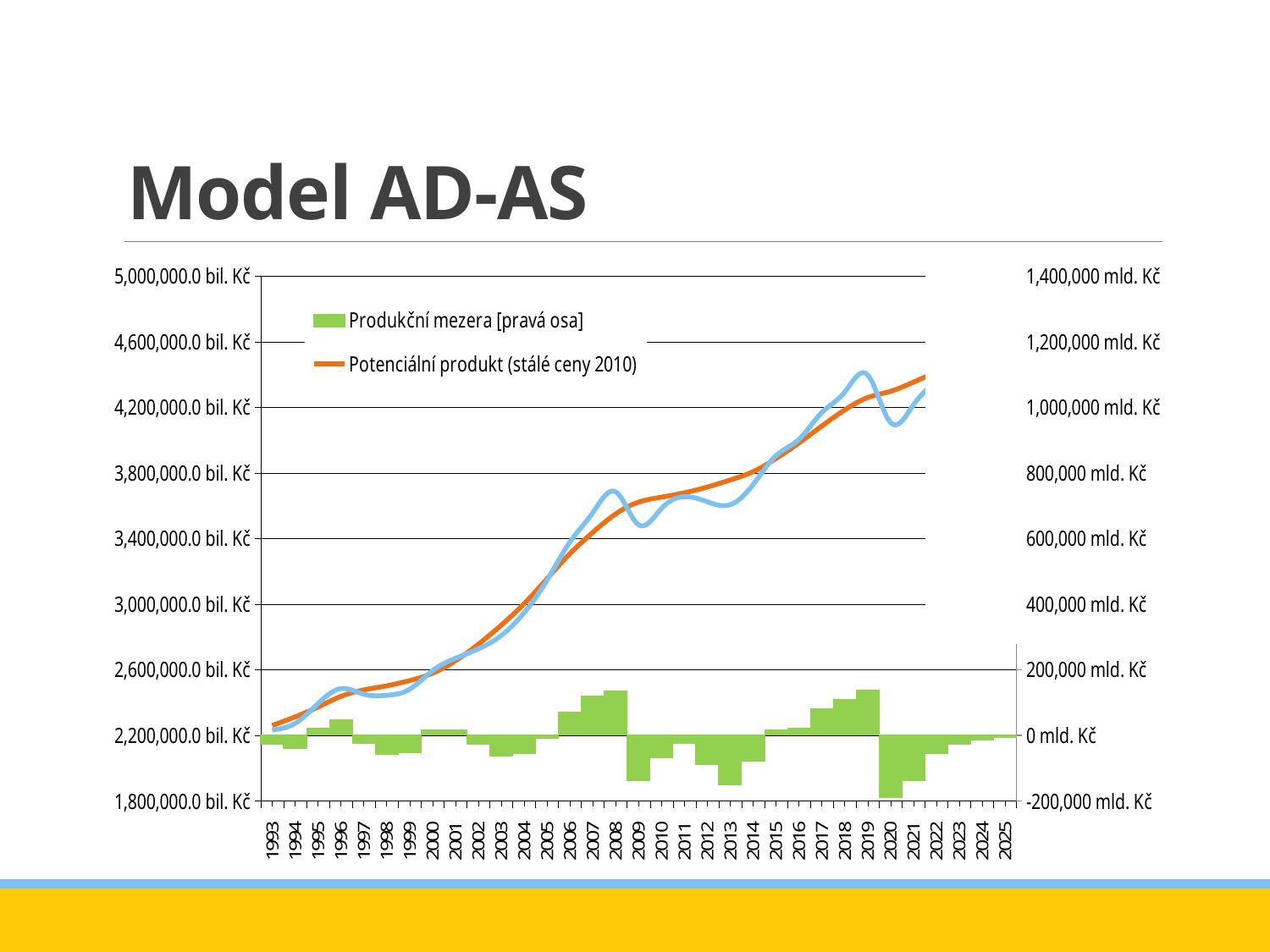
How many series does the chart legend list? 2 In which year is the Produkční mezera bar the lowest? 2020 Is the Potenciální produkt value for 2025 greater or less than 4,200,000.0 bil. Kč? greater What kind of chart is shown on the slide? Combination chart with bars and lines Is the Produkční mezera value for 2008 greater or less than 0 mld. Kč? greater Does the Potenciální produkt (stálé ceny 2010) line rise or fall from 1993 to 2025? rises Which year has the larger Produkční mezera value, 2006 or 2007? 2007 Is the Potenciální produkt value for 1993 greater or less than 2,600,000.0 bil. Kč? less What colour are the Produkční mezera bars? Green How many years are shown on the x axis of the chart? 33 What is the first legend entry of the chart? Produkční mezera [pravá osa]